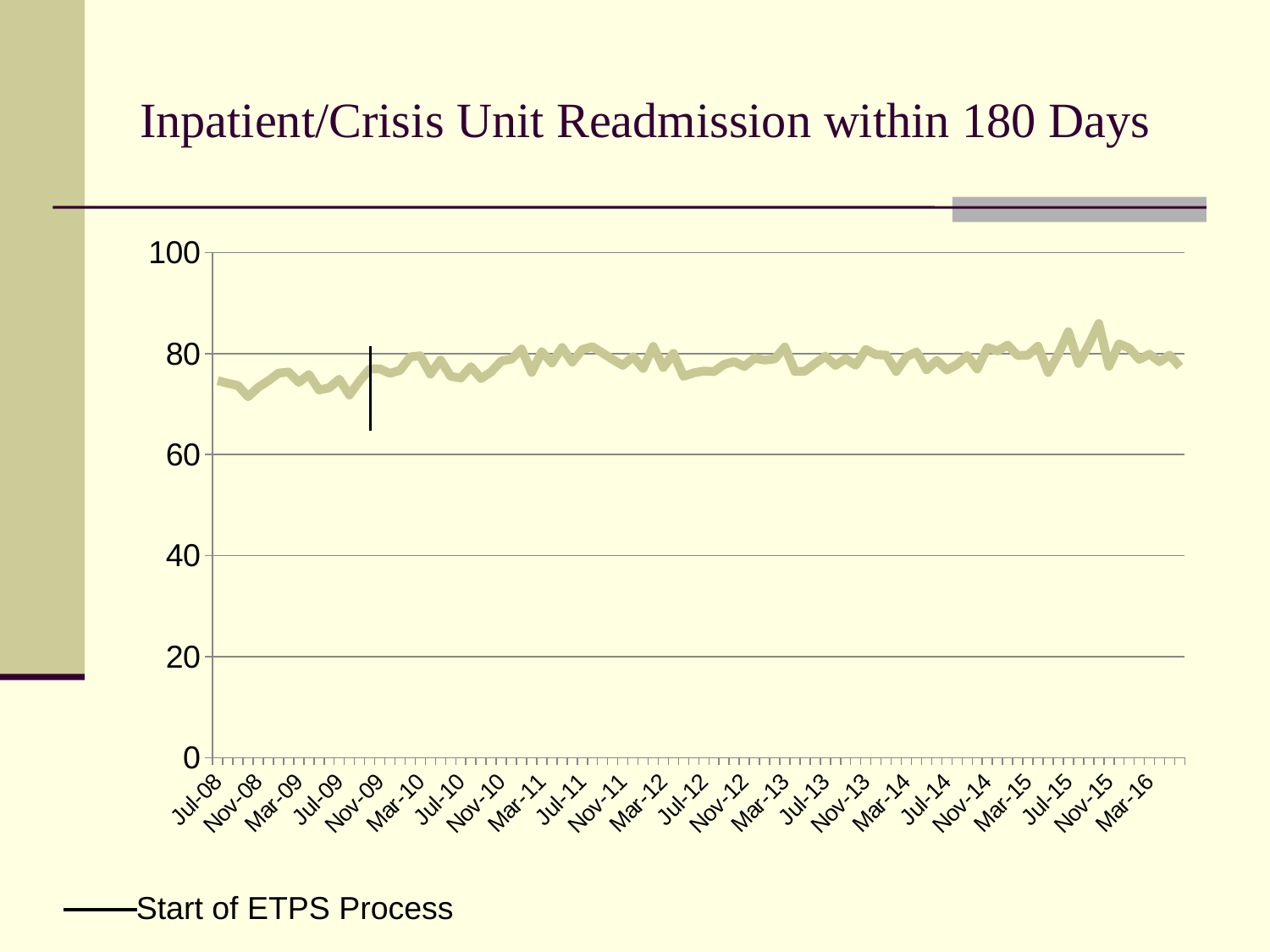
What kind of chart is shown on the slide? line chart What does the vertical black line on the chart mark, according to the legend? Start of ETPS Process Is the value for Jul-08 greater or less than 60? greater Do the values generally rise or fall from Jul-08 to Mar-16? rise What is the title of the chart? Inpatient/Crisis Unit Readmission within 180 Days Is the value for Jul-08 greater or less than 80? less Is the value for Nov-09 greater or less than 40? greater How many date labels are shown along the x axis? 24